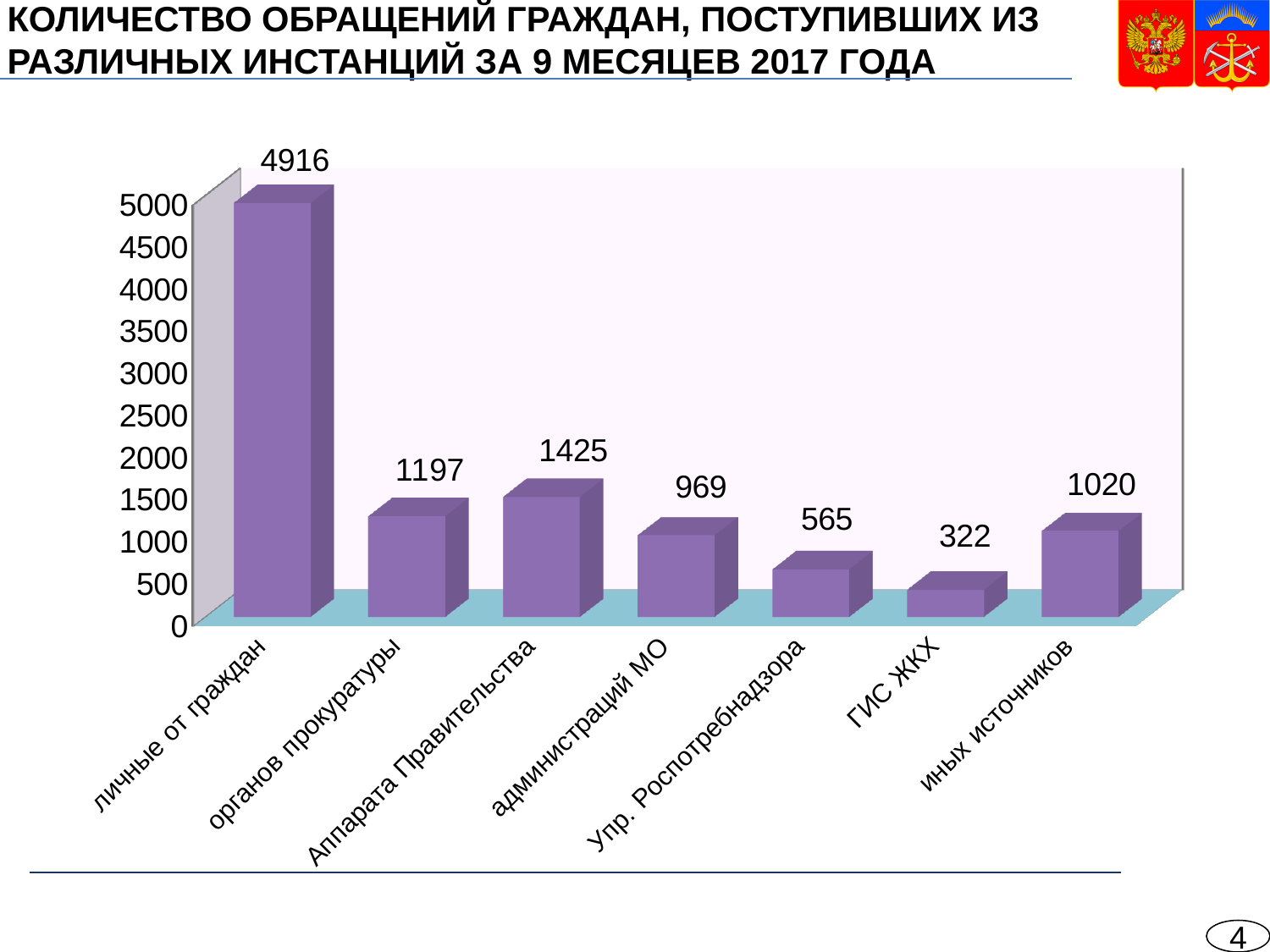
What is the value for личные от граждан? 4916 What is the value for органов прокуратуры? 1197 What is the difference between the values for личные от граждан and ГИС ЖКХ? 4594 How many categories are shown on the chart? 7 What is the difference between the values for Аппарата Правительства and органов прокуратуры? 228 What is the value for Аппарата Правительства? 1425 What kind of chart is shown on the slide? bar chart What is the value for Упр. Роспотребнадзора? 565 What is the value for иных источников? 1020 Which is larger, the value for администраций МО or the value for иных источников? иных источников Which category has the highest value? личные от граждан Which category has the lowest value? ГИС ЖКХ